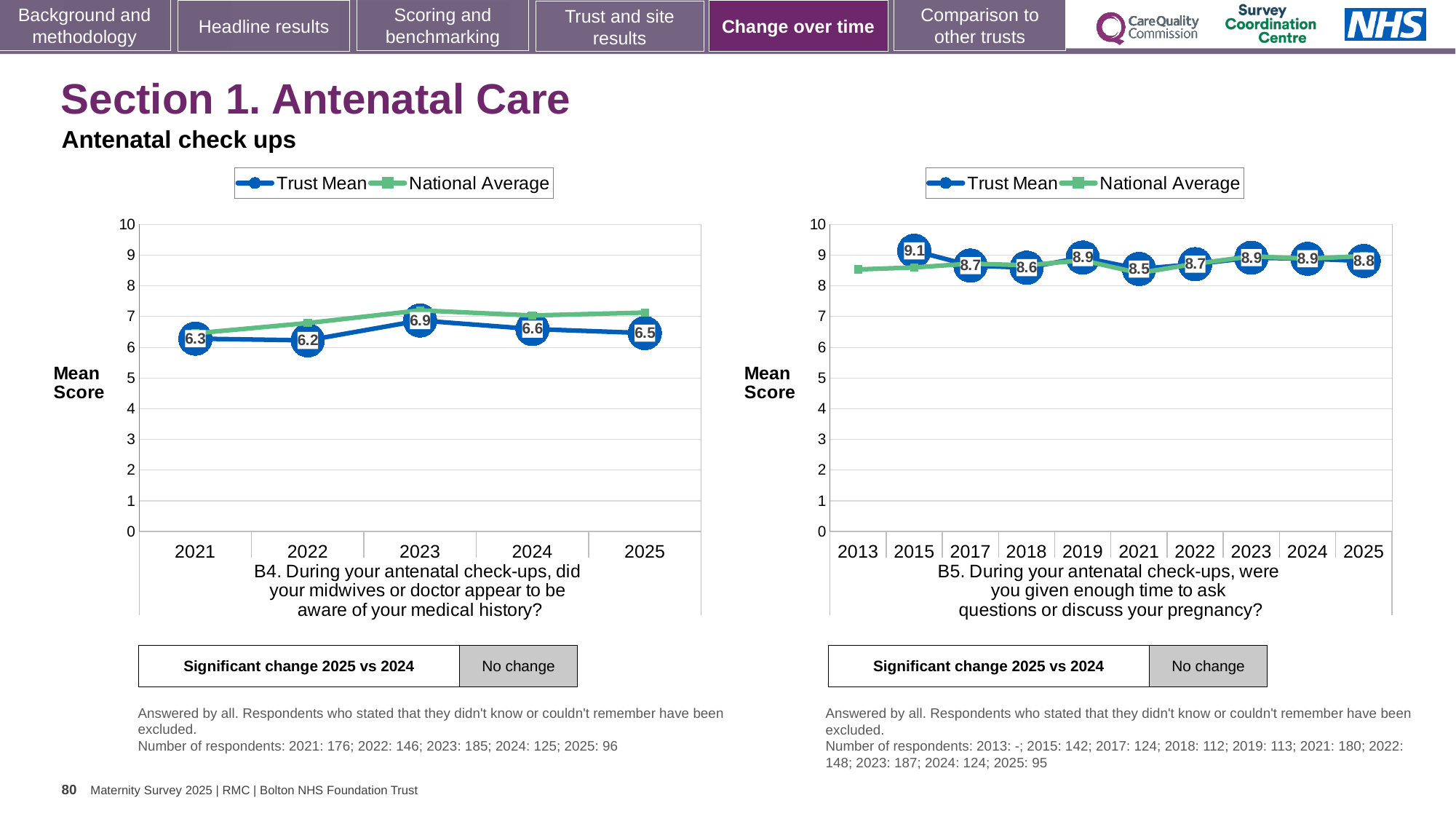
On the right chart (B5), what is the Trust Mean for 2021? 8.5 On the left chart (B4), which year has the lowest Trust Mean? 2022 On the left chart (B4), what is the Trust Mean for 2023? 6.9 On the right chart (B5), which year has the highest Trust Mean? 2015 On the right chart (B5), which is larger, the Trust Mean for 2019 or for 2018? 2019 On the right chart (B5), how many series does the legend list? 2 On the right chart (B5), what is the Trust Mean for 2015? 9.1 On the left chart (B4), is the National Average for 2021 greater or less than 7? less On the left chart (B4), what is the Trust Mean for 2025? 6.5 What kind of chart is the right chart (B5)? line chart On the left chart (B4), how many years are shown on the x axis? 5 On the left chart (B4), what is the difference between the Trust Mean in 2023 and in 2022? 0.7